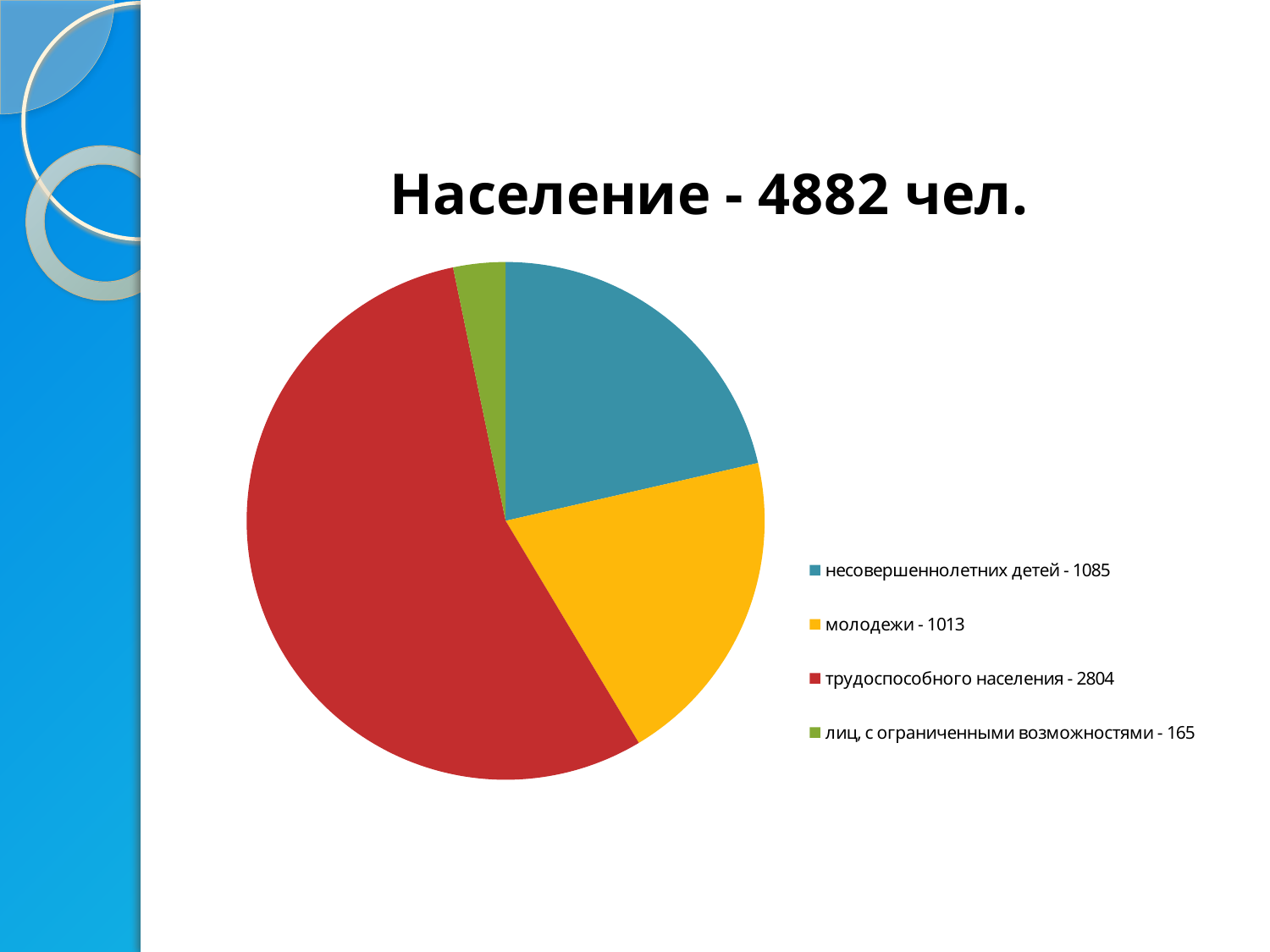
How many entries does the legend list? 4 Which category has the largest slice of the pie? трудоспособного населения What is the value for несовершеннолетних детей? 1085 What is the value for трудоспособного населения? 2804 What is the value for лиц, с ограниченными возможностями? 165 What type of chart is shown on the slide? pie chart What is the difference between the values for трудоспособного населения and несовершеннолетних детей? 1719 How many slices does the pie chart have? 4 What is the title of the chart? Население - 4882 чел. Which category has the smallest slice of the pie? лиц, с ограниченными возможностями Which colour represents молодежи in the pie chart? yellow What is the value for молодежи? 1013